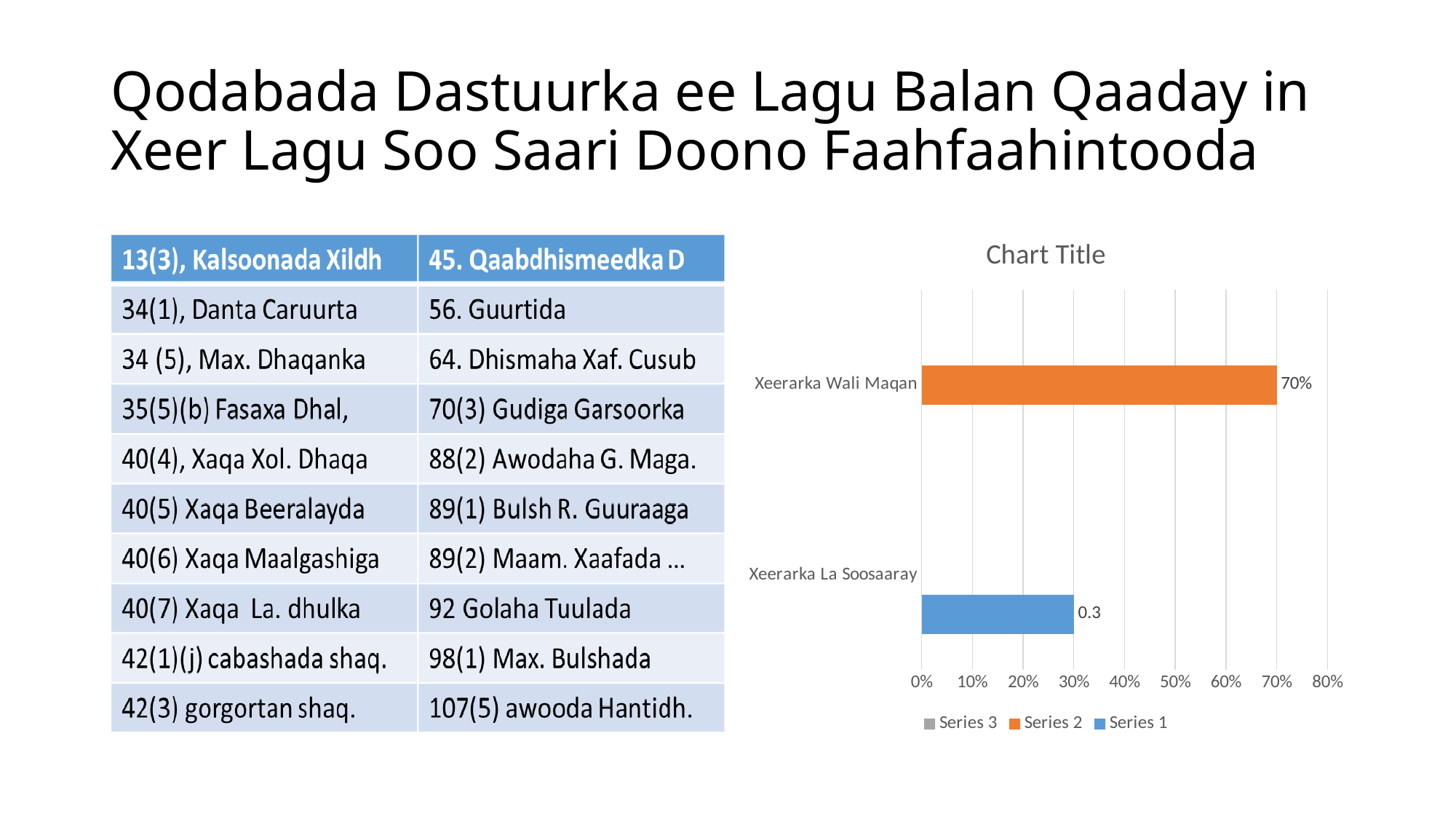
What colour is the bar for Xeerarka Wali Maqan? orange Is the value for Xeerarka La Soosaaray greater or less than 50%? less What kind of chart is shown on the slide? bar chart How many categories are plotted on the chart? 2 What is the title of the chart? Chart Title Which category has the shortest bar? Xeerarka La Soosaaray What is the data label shown on the bar for Xeerarka La Soosaaray? 0.3 How many series does the legend list? 3 Is the value for Xeerarka Wali Maqan greater or less than 60%? greater Which category has the longest bar? Xeerarka Wali Maqan Which is larger, the bar for Xeerarka Wali Maqan or the bar for Xeerarka La Soosaaray? Xeerarka Wali Maqan What is the value shown for Xeerarka Wali Maqan? 70%